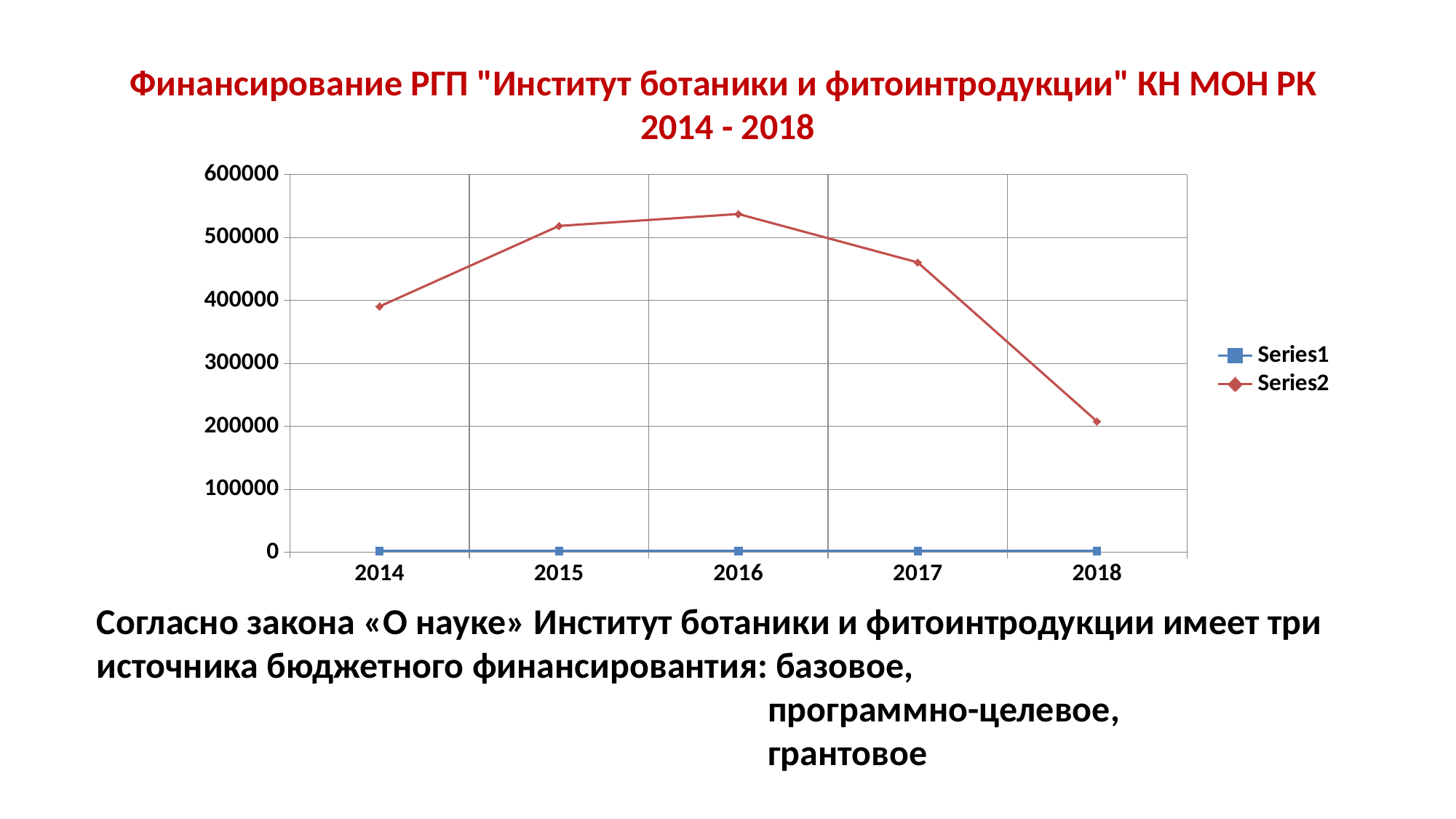
Is the value of Series2 in 2016 greater or less than 500000? greater In which year does Series2 have its lowest value? 2018 Is the value of Series2 in 2014 greater or less than 400000? less How many series does the legend list? 2 In which year does Series2 reach its highest value? 2016 Does Series2 rise or fall from 2016 to 2018? fall What kind of chart is shown on the slide? line chart Is the value of Series2 in 2018 greater or less than 300000? less How many years are shown on the x axis? 5 Which is larger for Series2: the value in 2015 or the value in 2018? 2015 What colour is the Series2 line? red